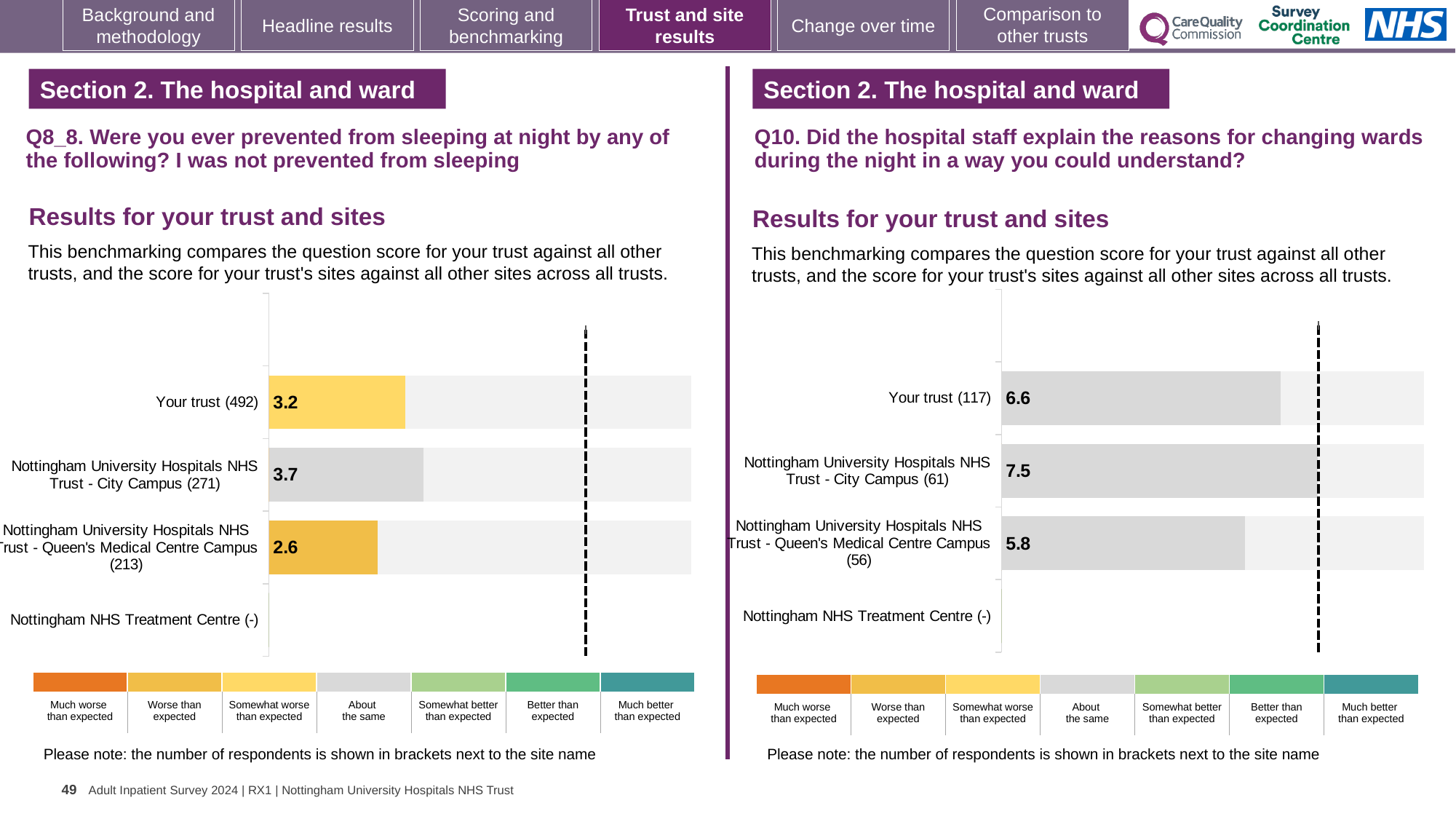
On the right chart (Q10), is the score for Your trust (117) larger or smaller than the score for City Campus (61)? smaller What kind of chart is used on the left side of the slide (Q8_8)? bar chart On the left chart (Q8_8), what is the score for Your trust (492)? 3.2 On the right chart (Q10), what is the score for Nottingham University Hospitals NHS Trust - Queen's Medical Centre Campus (56)? 5.8 On the left chart (Q8_8), what is the difference between the City Campus score and the Queen's Medical Centre Campus score? 1.1 On the left chart (Q8_8), which site or trust has the highest score? Nottingham University Hospitals NHS Trust - City Campus (271) On the right chart (Q10), what is the score for Nottingham University Hospitals NHS Trust - City Campus (61)? 7.5 On the right chart (Q10), how many categories are listed on the vertical axis? 4 On the left chart (Q8_8), what is the score for Nottingham University Hospitals NHS Trust - City Campus (271)? 3.7 On the left chart (Q8_8), what is the score for Nottingham University Hospitals NHS Trust - Queen's Medical Centre Campus (213)? 2.6 On the right chart (Q10), which site or trust has the lowest score? Nottingham University Hospitals NHS Trust - Queen's Medical Centre Campus (56) On the right chart (Q10), what is the score for Your trust (117)? 6.6